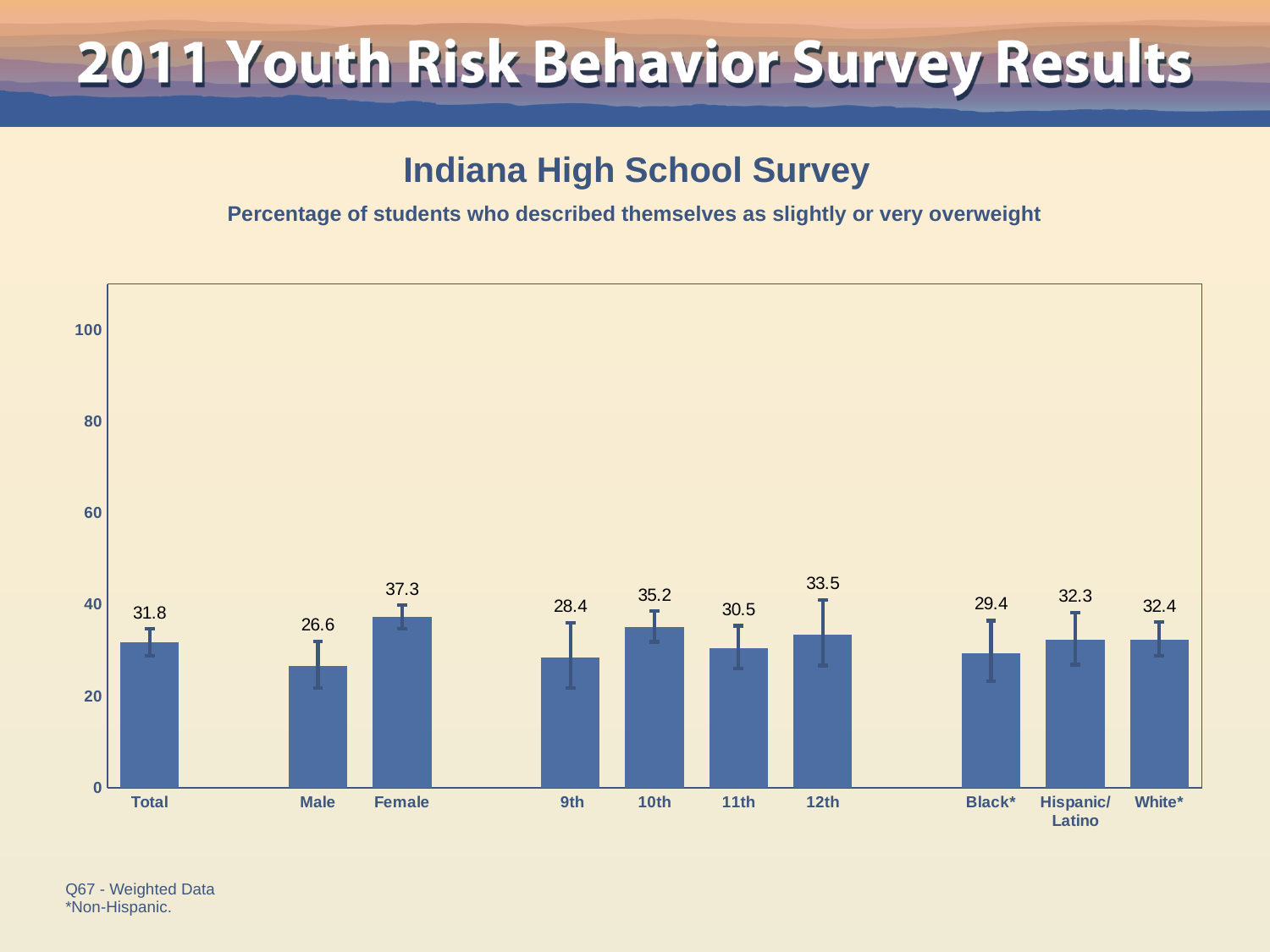
What is the value for Female? 37.3 What is the value for Hispanic/Latino? 32.3 What is the value for 9th grade? 28.4 Which category has the lowest value? Male What is the difference between the Female and Male values? 10.7 What is the subtitle describing what the chart measures? Percentage of students who described themselves as slightly or very overweight Is the value for 12th grade greater or less than 40? less What is the difference between the Total value and the Black* value? 2.4 Which category has the highest value? Female How many bars are shown in the chart? 10 What kind of chart is shown? bar chart Which is larger, the value for 10th grade or 11th grade? 10th